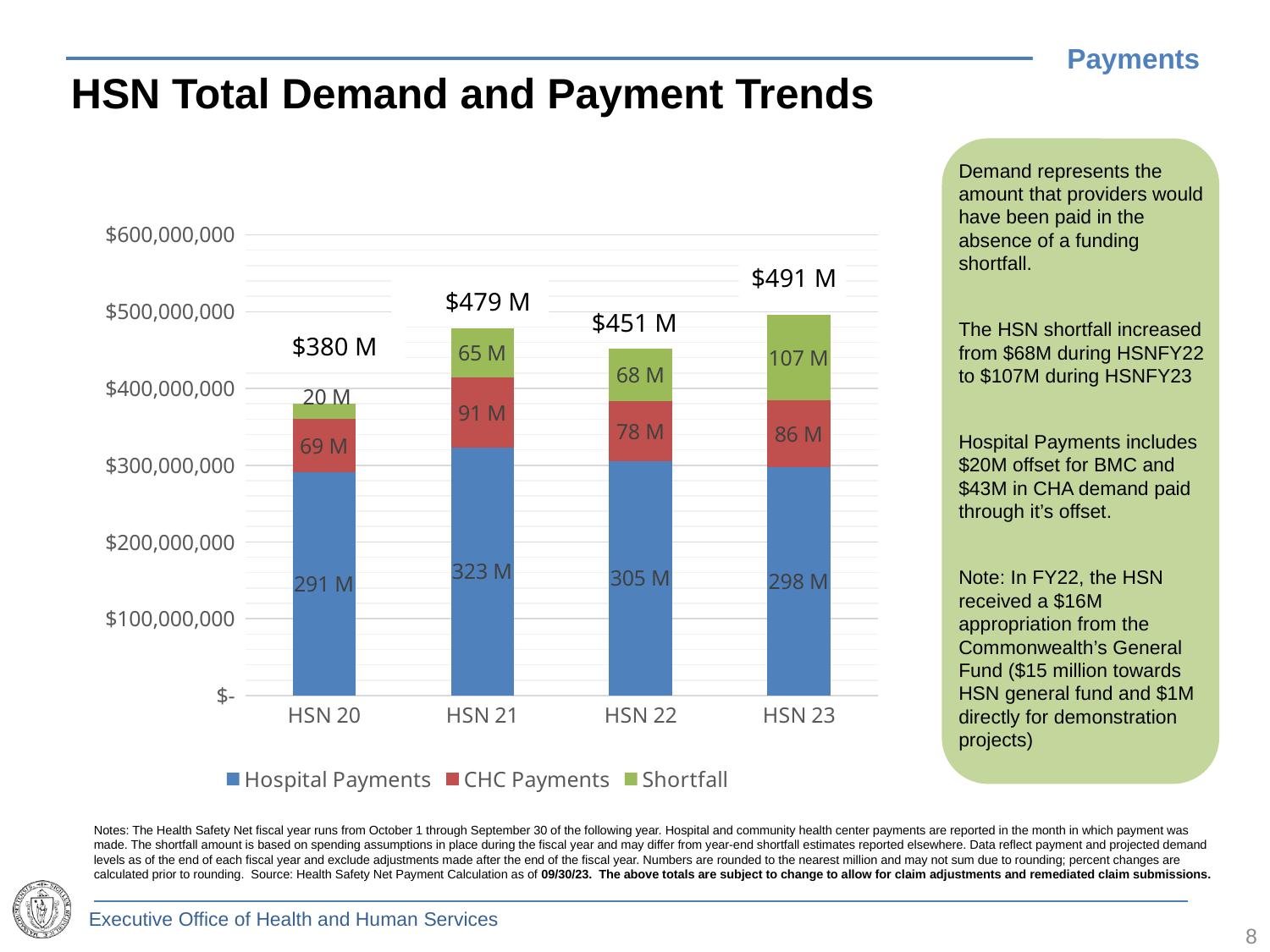
Which series is shown in green in the legend? Shortfall What is the Shortfall value for HSN 23? 107 M Which fiscal year has the lowest Hospital Payments? HSN 20 What is the difference between the Shortfall for HSN 23 and the Shortfall for HSN 22? 39 M Which is larger, CHC Payments for HSN 21 or CHC Payments for HSN 23? HSN 21 What is the CHC Payments value for HSN 22? 78 M What is the total labelled above the HSN 20 bar? $380 M What is the Hospital Payments value for HSN 21? 323 M How many series does the legend list? 3 Which fiscal year has the highest Shortfall? HSN 23 What kind of chart is shown on the slide? Stacked bar chart How many fiscal years are shown on the x axis? 4